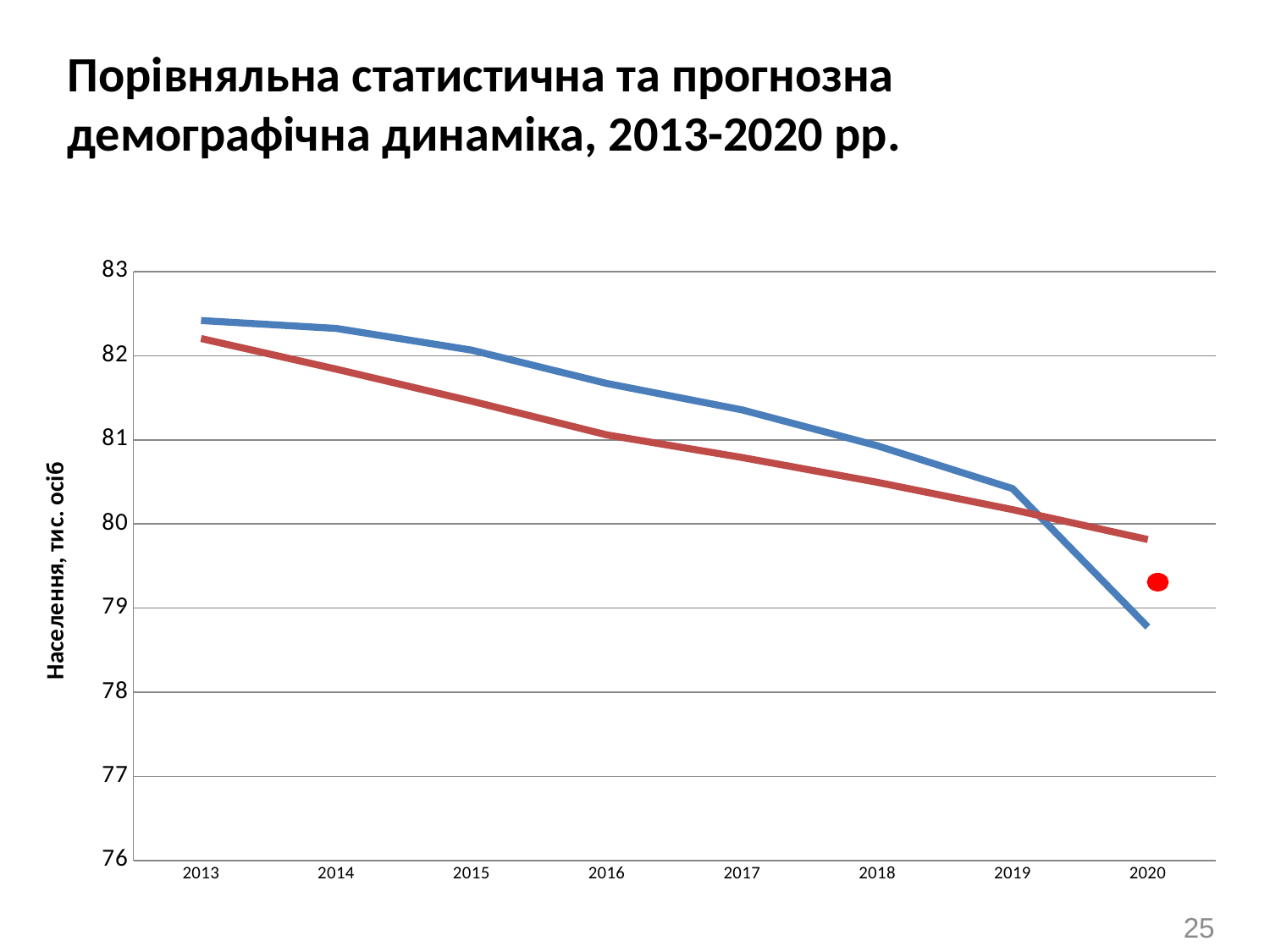
How many lines are plotted on the chart? 2 In 2020, which line has the higher value, the blue line or the red line? the red line Is the value of the red line in 2017 greater or less than 81? less Do the values of the blue line rise or fall from 2013 to 2020? fall Is the value of the blue line in 2020 greater or less than 79? less How many years are shown along the x axis of the chart? 8 What kind of chart is shown on the slide? line chart In 2013, which line has the higher value, the blue line or the red line? the blue line Is the value of the blue line in 2013 greater or less than 82? greater What is the label of the vertical axis of the chart? Населення, тис. осіб Do the values of the red line rise or fall from 2013 to 2020? fall